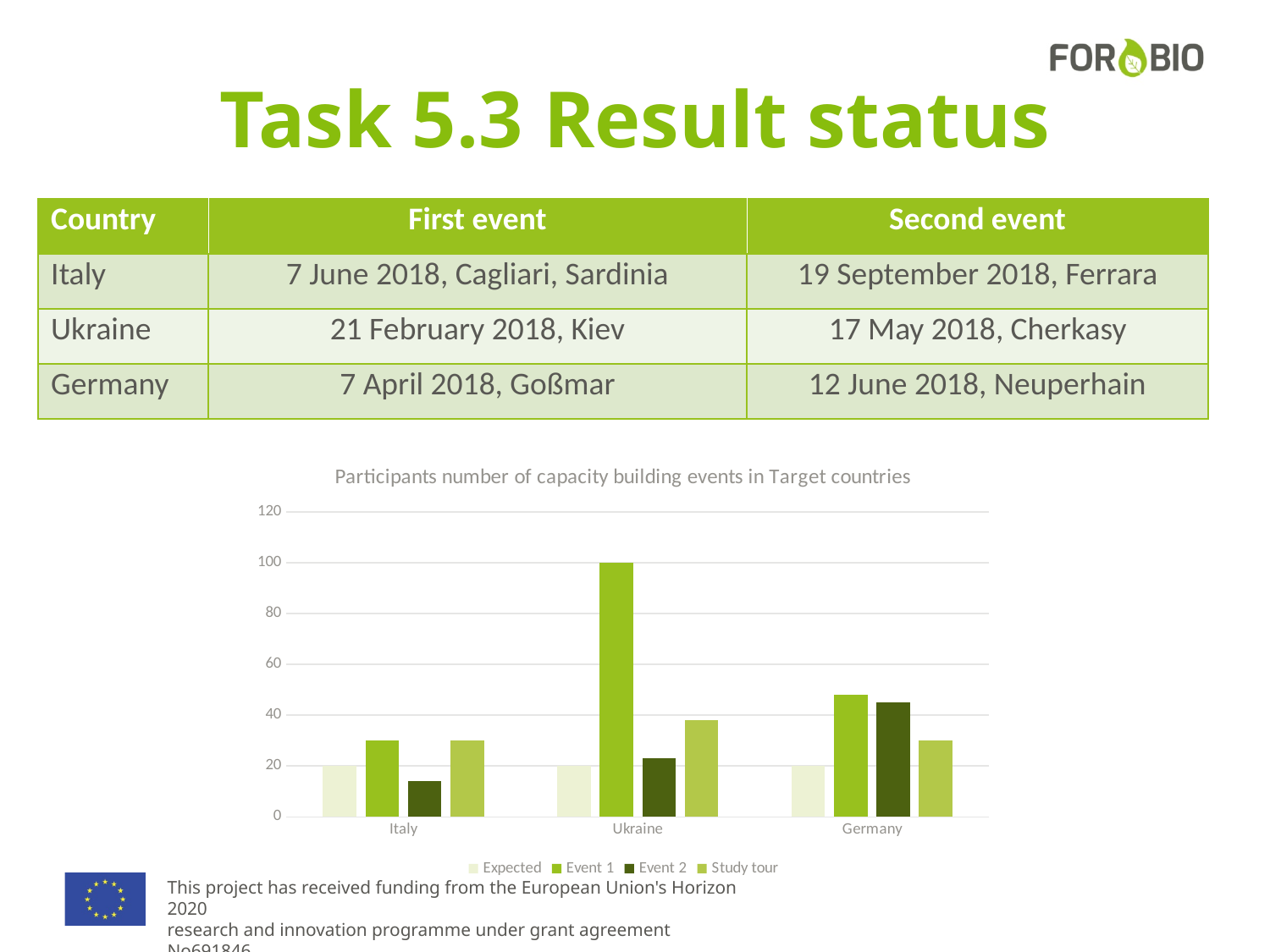
Is the Event 2 value for Italy greater or less than 20? less Is the Event 1 value for Germany greater or less than 40? greater What type of chart is shown on the slide? bar chart What is the title of the chart? Participants number of capacity building events in Target countries Which country has the highest Event 1 value? Ukraine What is the Expected value for Italy? 20 What is the Event 1 value for Ukraine? 100 How many countries are shown on the x axis of the chart? 3 Which is larger, the Event 1 value for Ukraine or the Event 1 value for Germany? Ukraine Which series is listed first in the chart legend? Expected How many series does the chart legend list? 4 Which country has the lowest Event 2 value? Italy